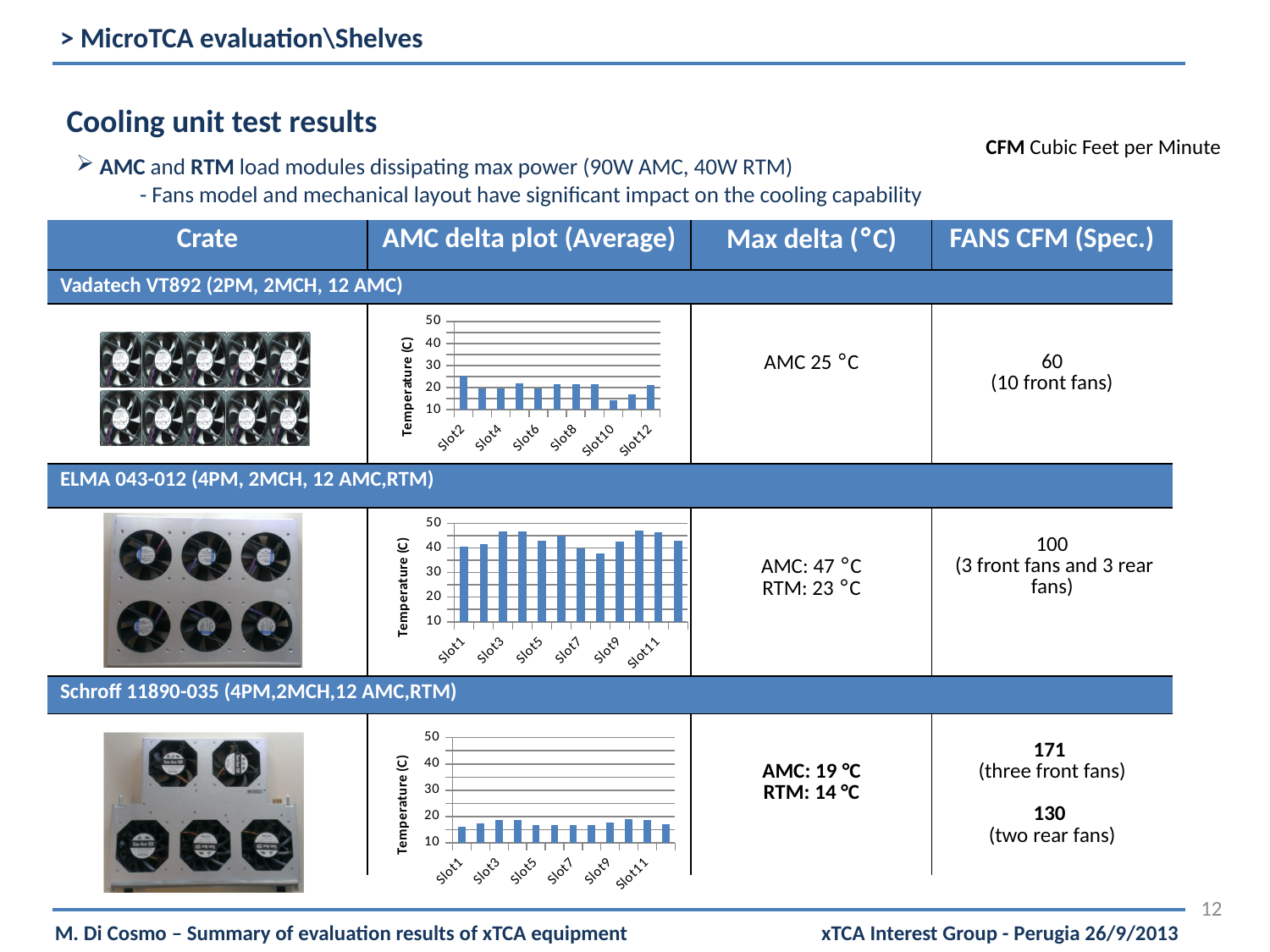
In the Schroff 11890-035 AMC delta plot, are any bars above 30 on the y axis? No In the Vadatech VT892 AMC delta plot, is the value for Slot10 greater or less than 20? less In the ELMA 043-012 AMC delta plot, which is larger, the value for Slot3 or the value for Slot8? Slot3 In the ELMA 043-012 AMC delta plot, is the value for Slot3 greater or less than 40? greater What kind of chart is shown in the AMC delta plot for the Vadatech VT892 crate? bar chart How many bars (slots) are plotted in the AMC delta plot for the ELMA 043-012 crate? 12 In the Vadatech VT892 AMC delta plot, which slot has the lowest bar? Slot10 In the Vadatech VT892 AMC delta plot, which slot has the highest bar? Slot2 What is the highest value shown on the y axis of the Schroff 11890-035 AMC delta plot? 50 What is the y-axis label on the ELMA 043-012 AMC delta plot? Temperature (C)